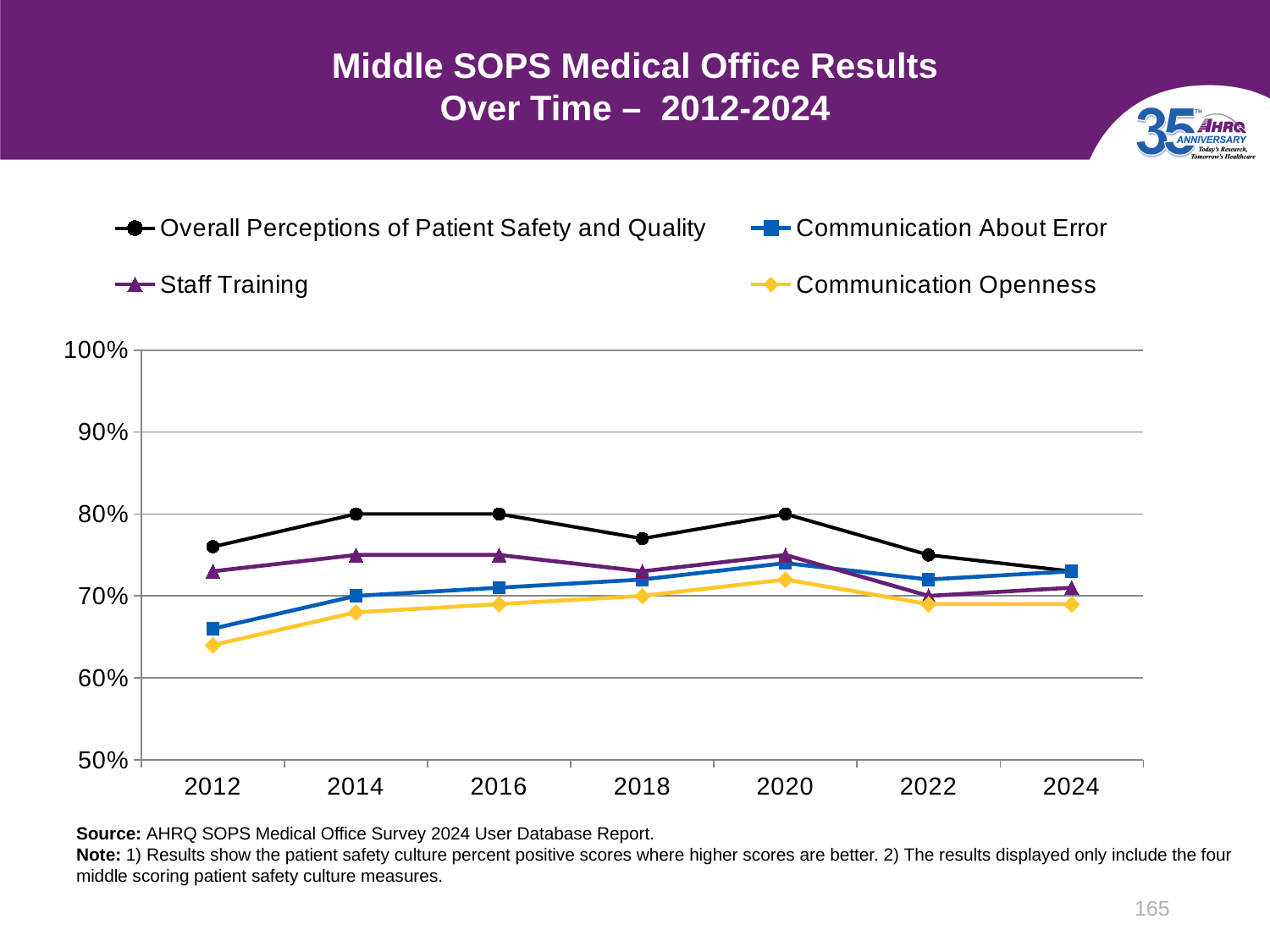
How many years are shown along the x axis? 7 Which is larger in 2012: Staff Training or Communication About Error? Staff Training Which series has the lowest value in 2012? Communication Openness Is the value for Overall Perceptions of Patient Safety and Quality in 2012 greater or less than 70%? greater Is the value for Communication About Error in 2012 greater or less than 70%? less In which year is Communication Openness at its lowest? 2012 Is the value for Communication Openness in 2012 greater or less than 70%? less How many series does the legend list? 4 Which series has the highest value in 2012? Overall Perceptions of Patient Safety and Quality What kind of chart is shown on the slide? line chart Does the Overall Perceptions of Patient Safety and Quality line rise or fall from 2020 to 2024? fall